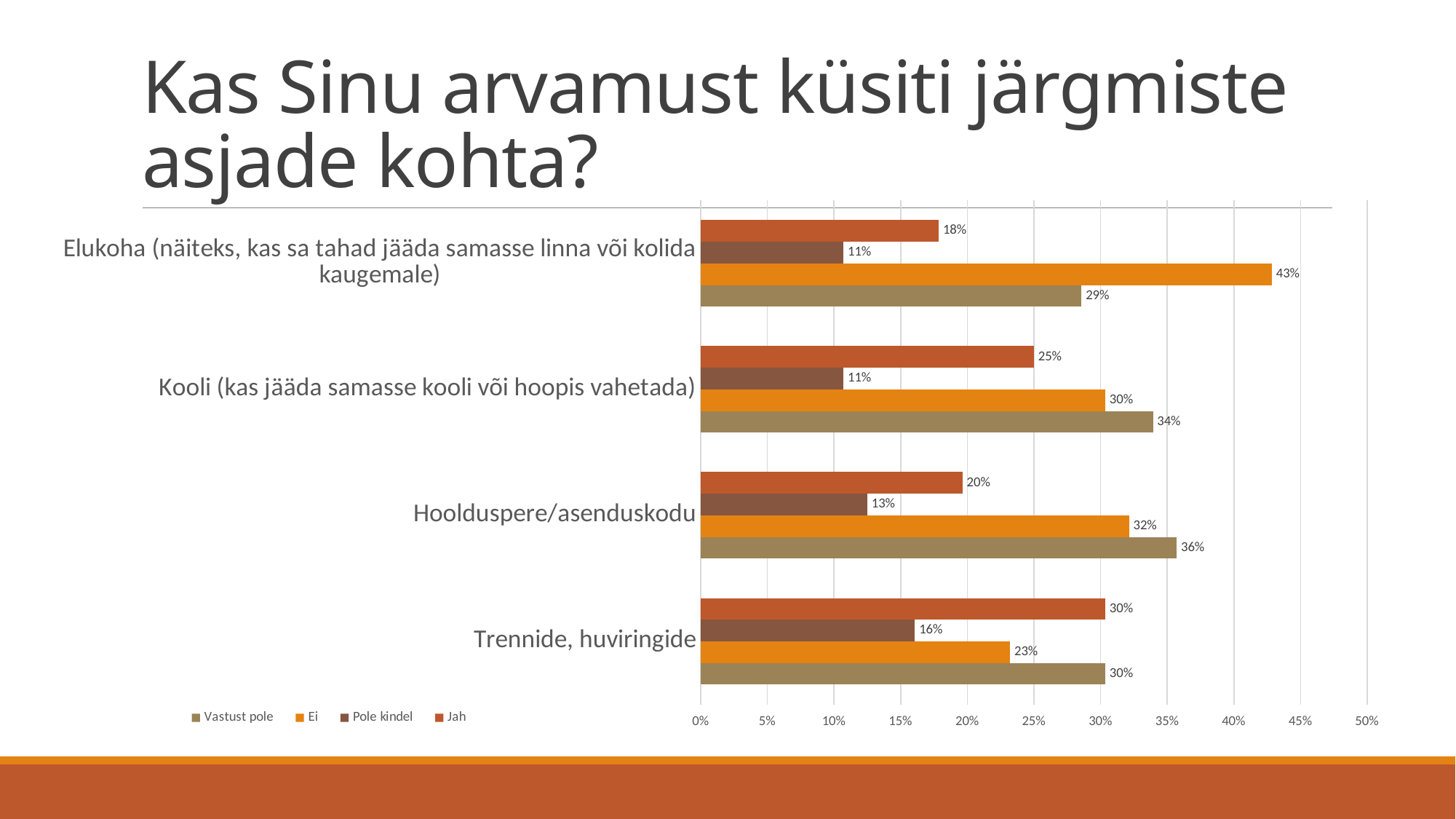
What is the value of 'Vastust pole' for 'Kooli (kas jääda samasse kooli või hoopis vahetada)'? 34% What is the value of 'Ei' for the 'Elukoha' category? 43% What kind of chart is shown on the slide? bar chart How many categories are shown on the chart? 4 Which category has the lowest 'Ei' value? Trennide, huviringide What is the difference between the 'Ei' and 'Jah' values for the 'Elukoha' category? 25% How many series does the legend list? 4 For 'Hoolduspere/asenduskodu', which is larger: 'Vastust pole' or 'Ei'? Vastust pole What is the value of 'Jah' for 'Trennide, huviringide'? 30% What is the value of 'Pole kindel' for 'Hoolduspere/asenduskodu'? 13% Which series is shown in orange in the legend? Ei Which category has the highest 'Jah' value? Trennide, huviringide